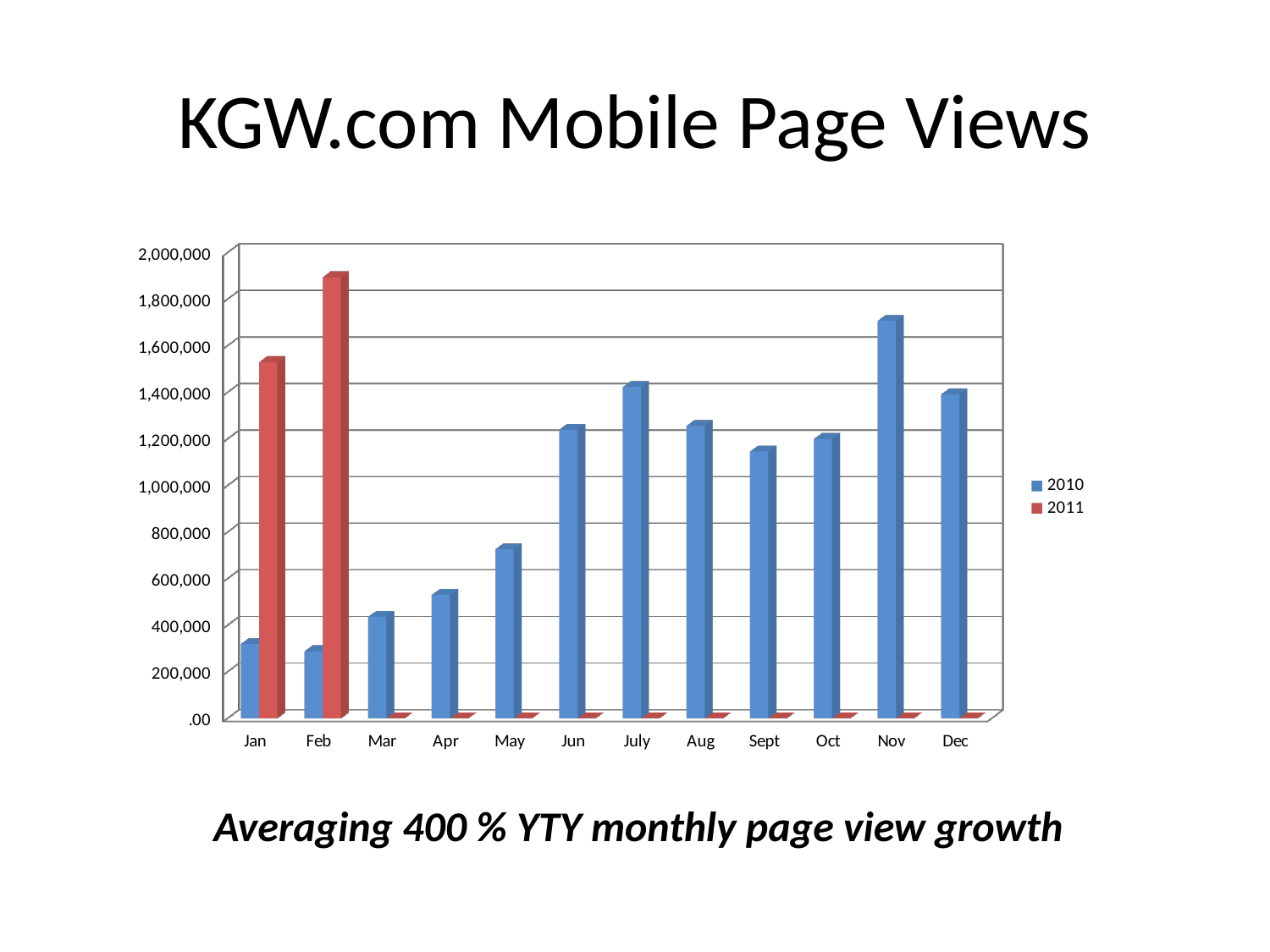
Which month has the highest value for the 2011 series? Feb Which month has the highest value for the 2010 series? Nov How many series does the legend list? 2 Is the value for Feb in the 2011 series greater or less than 1,800,000? greater Is the value for Jan in the 2011 series greater or less than 1,400,000? greater What kind of chart is shown on the slide? bar chart Is the value for Nov in the 2010 series greater or less than 1,600,000? greater For Jan, which series has the larger value, 2010 or 2011? 2011 Which is larger in the 2010 series, July or Aug? July Do the 2010 values rise or fall from Feb to Jun? rise How many months are shown on the x axis? 12